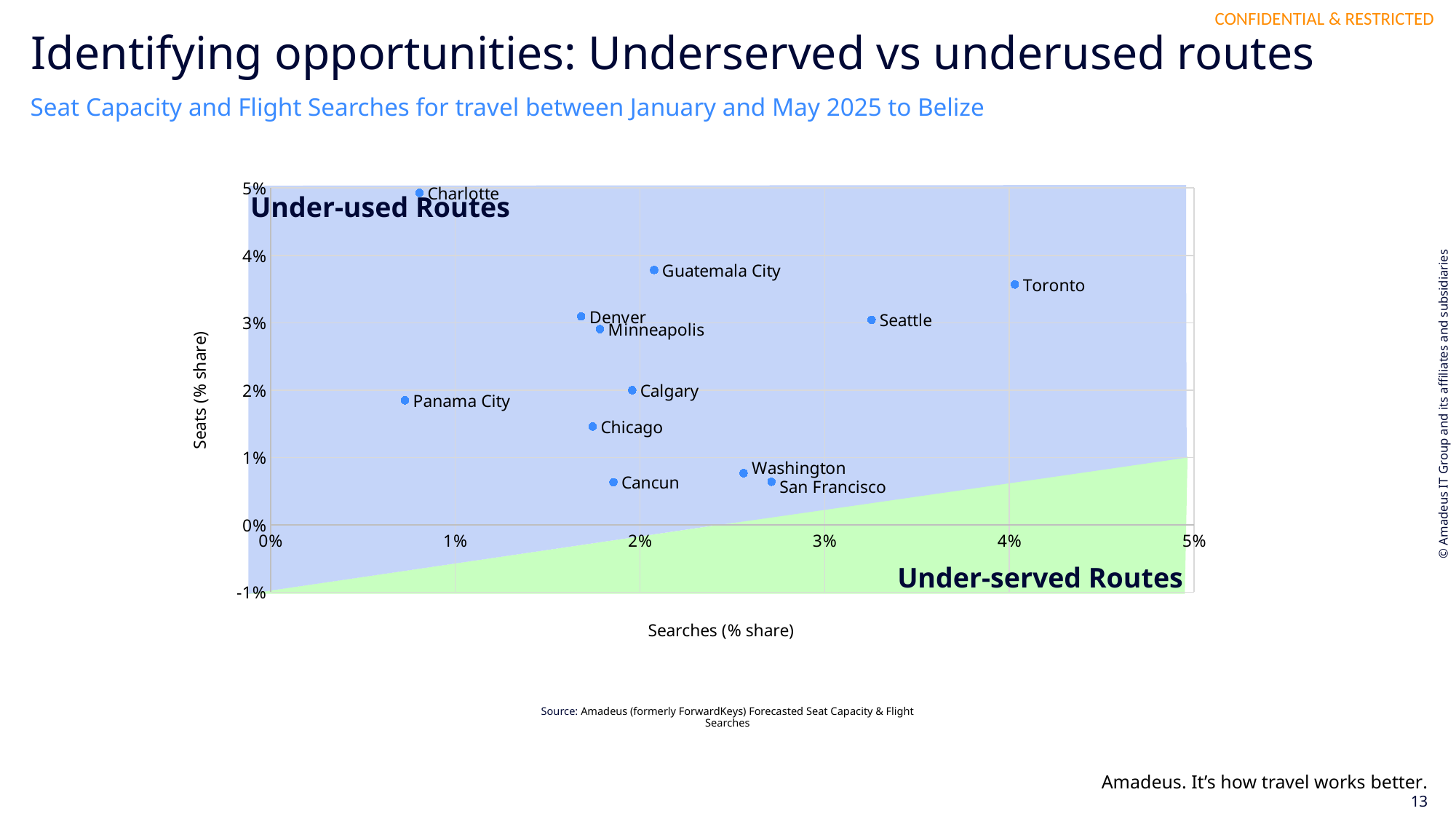
Which city has the highest seats (% share)? Charlotte Is the seats (% share) value for Chicago greater or less than 1%? greater How many cities are plotted on the chart? 12 What kind of chart is shown on the slide? Scatter chart Is the searches (% share) value for Charlotte greater or less than 1%? less Which has a larger seats (% share), Guatemala City or Calgary? Guatemala City Which city has the highest searches (% share)? Toronto Is the seats (% share) value for Cancun greater or less than 1%? less What is the label of the horizontal axis? Searches (% share) Which has a larger searches (% share), Toronto or Seattle? Toronto